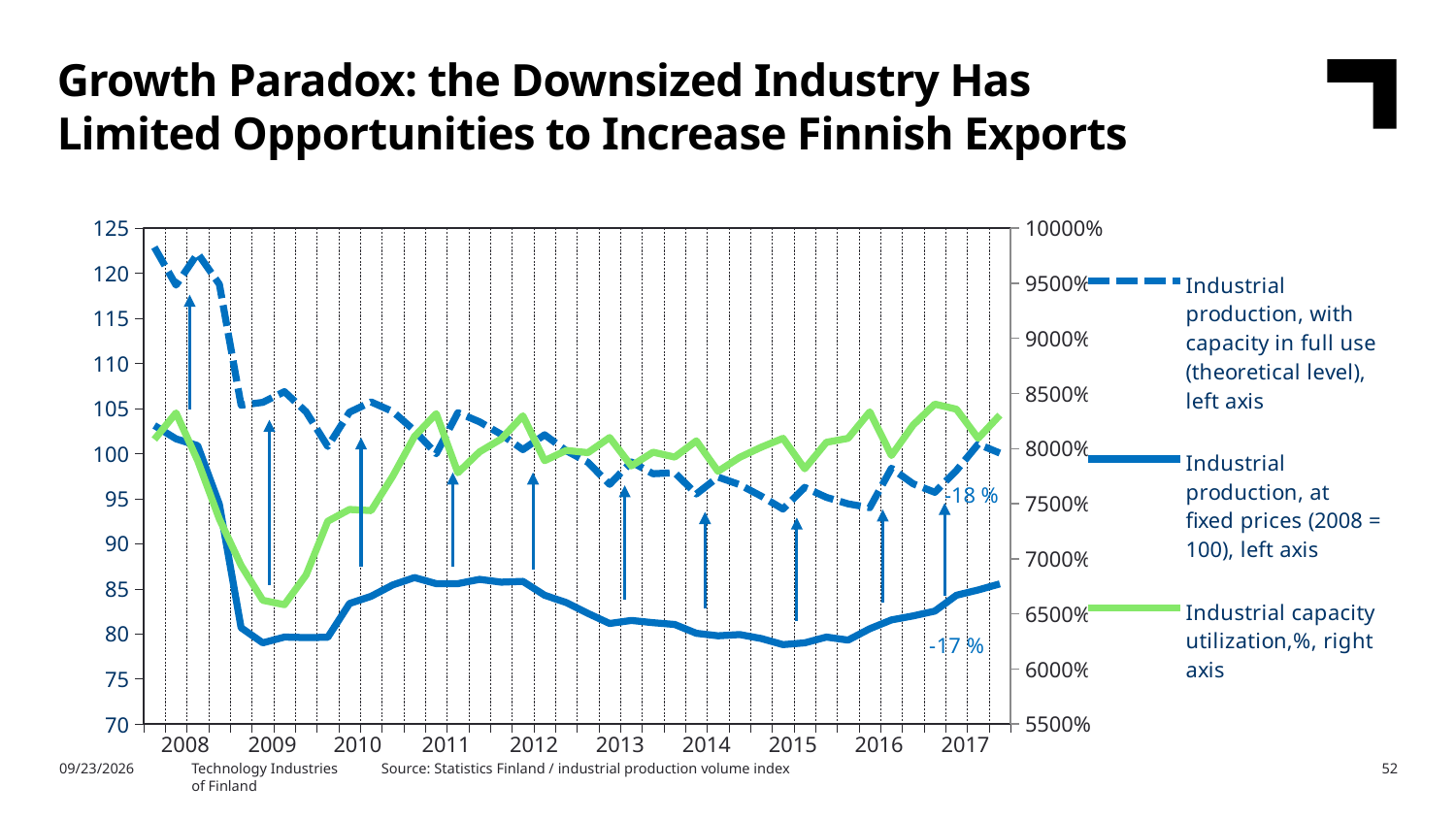
What percentage change is annotated next to the solid blue line near the end of the chart? -17 % What percentage change is annotated next to the dashed line near the end of the chart? -18 % Does the solid blue line (industrial production at fixed prices) rise or fall from 2008 to 2009? fall Is the value of the dashed line (theoretical level) at the start of 2008 greater or less than 115? greater What kind of chart is shown on the slide? line chart What base year is used for the industrial production at fixed prices series? 2008 = 100 Which axis does the industrial capacity utilization series use? right axis Is the value of the solid blue line (industrial production at fixed prices) in 2009 greater or less than 85? less In 2009, which is higher: the dashed line (theoretical level) or the solid blue line (fixed prices)? the dashed line (theoretical level) How many series does the legend list? 3 Is the value of the solid blue line in 2017 greater or less than 90? less How many years are labelled on the x axis? 10